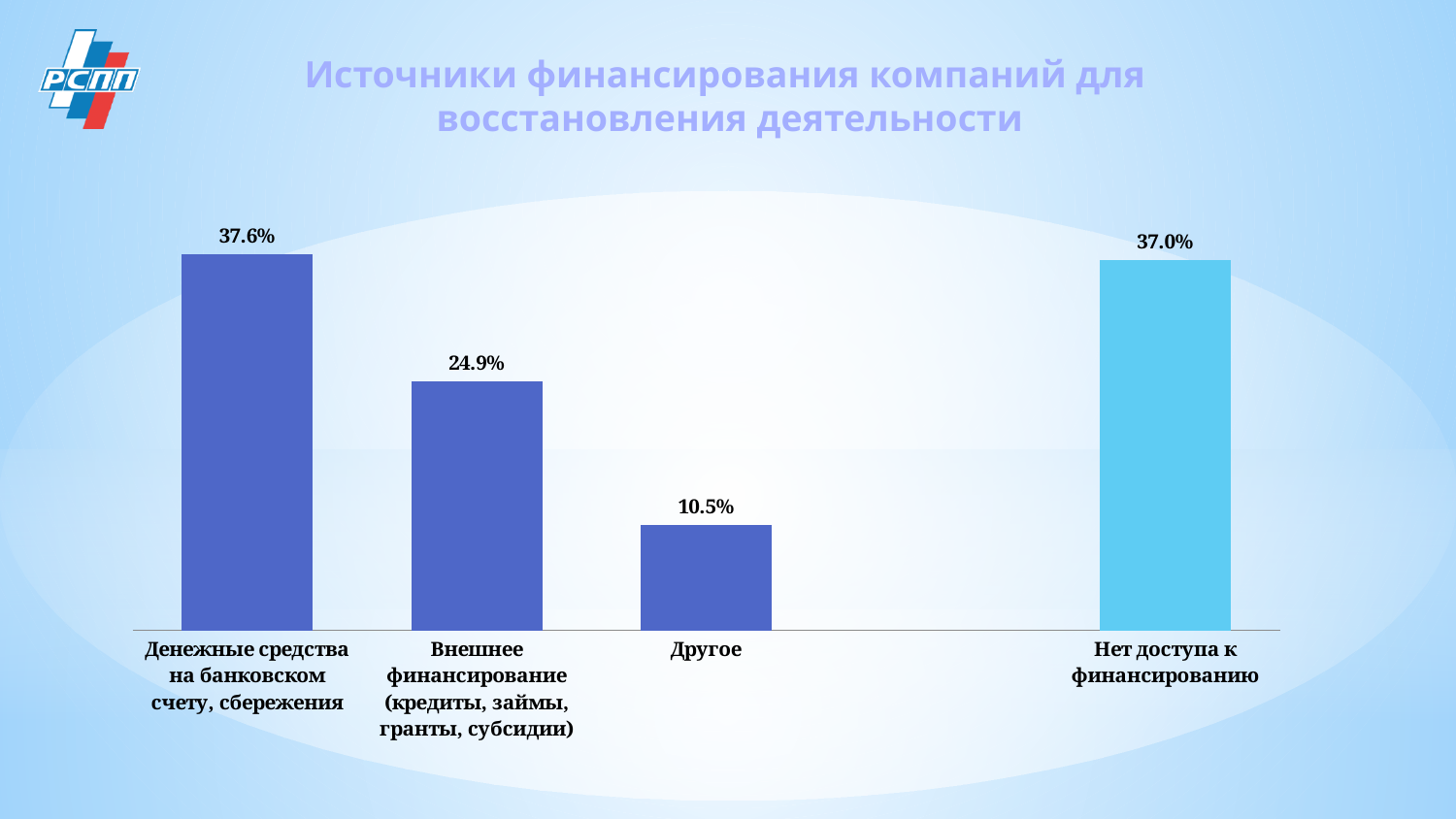
What is the value for «Нет доступа к финансированию»? 37.0% What kind of chart is shown on the slide? Bar chart Which category has the highest value? Денежные средства на банковском счету, сбережения What is the value for «Внешнее финансирование (кредиты, займы, гранты, субсидии)»? 24.9% What is the value for «Денежные средства на банковском счету, сбережения»? 37.6% Which is larger: the value for «Внешнее финансирование (кредиты, займы, гранты, субсидии)» or the value for «Нет доступа к финансированию»? Нет доступа к финансированию What is the difference between the values for «Денежные средства на банковском счету, сбережения» and «Нет доступа к финансированию»? 0.6% What is the title of the chart? Источники финансирования компаний для восстановления деятельности Which category has the lowest value? Другое What is the difference between the values for «Внешнее финансирование (кредиты, займы, гранты, субсидии)» and «Другое»? 14.4% What is the value for «Другое»? 10.5% How many categories are shown in the chart? 4